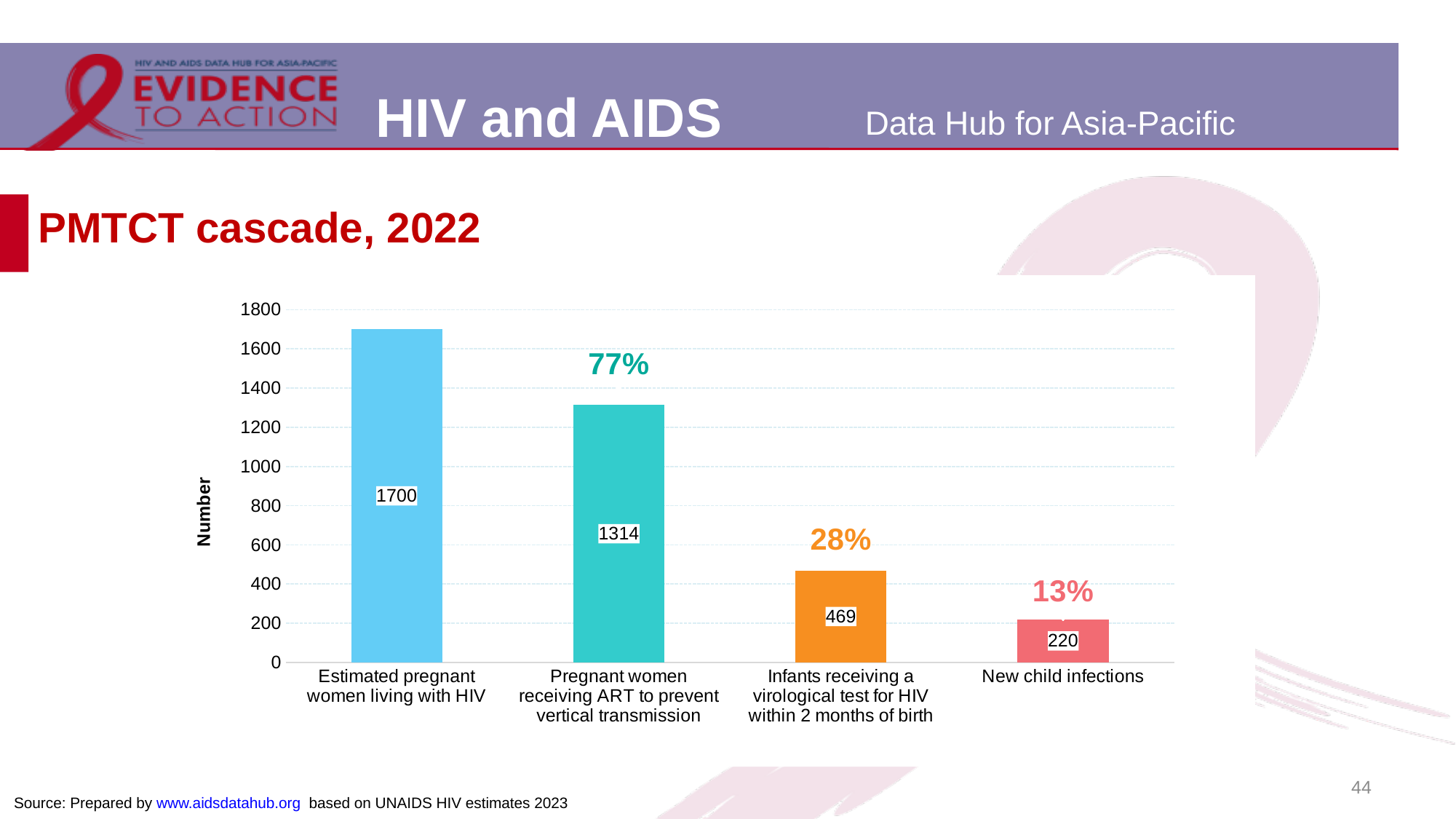
What is the value for Infants receiving a virological test for HIV within 2 months of birth? 469 How many categories are shown on the x axis? 4 What percentage is shown above the bar for New child infections? 13% What is the value for Pregnant women receiving ART to prevent vertical transmission? 1314 What kind of chart is shown on the slide? Bar chart What is the value for Estimated pregnant women living with HIV? 1700 Which is larger: the value for Infants receiving a virological test for HIV within 2 months of birth or the value for New child infections? Infants receiving a virological test for HIV within 2 months of birth Which category has the highest value? Estimated pregnant women living with HIV What percentage is shown above the bar for Pregnant women receiving ART to prevent vertical transmission? 77% What is the value for New child infections? 220 What is the difference between the values for Estimated pregnant women living with HIV and Pregnant women receiving ART to prevent vertical transmission? 386 Which category has the lowest value? New child infections